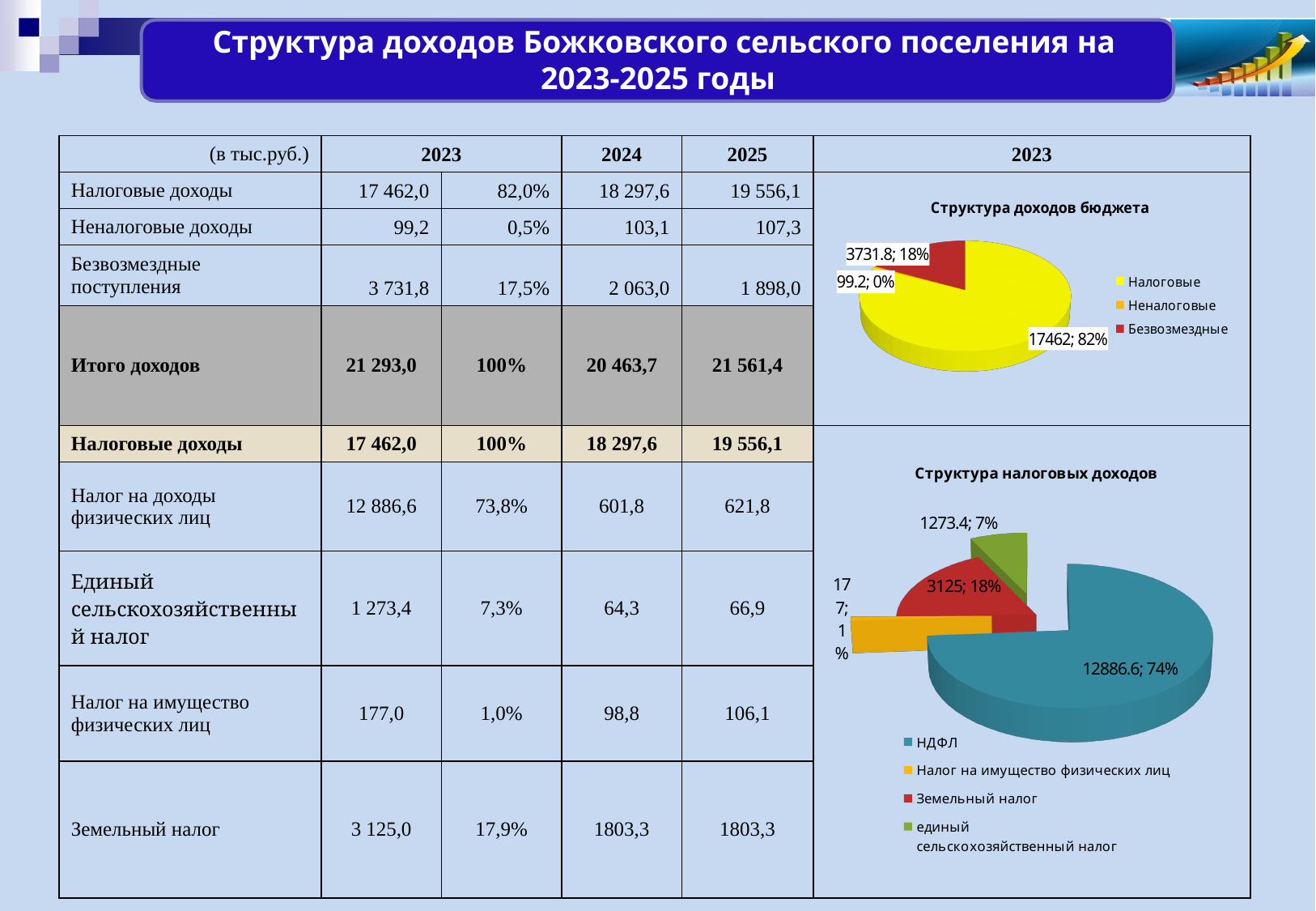
In the chart titled "Структура налоговых доходов", what is the difference between the НДФЛ value and the Земельный налог value? 9761.6 In the chart titled "Структура доходов бюджета", what share of the pie does the Безвозмездные slice have? 18% In the chart titled "Структура налоговых доходов", how many slices does the pie have? 4 In the chart titled "Структура доходов бюджета", what colour is the Безвозмездные slice? Red In the chart titled "Структура доходов бюджета", what value is shown for the Налоговые slice? 17462; 82% In the chart titled "Структура налоговых доходов", which category has the largest slice? НДФЛ In the chart titled "Структура налоговых доходов", which is larger: Земельный налог or единый сельскохозяйственный налог? Земельный налог In the chart titled "Структура доходов бюджета", how many entries does the legend list? 3 In the chart titled "Структура налоговых доходов", what share of the pie does НДФЛ have? 74% What type of chart is the chart titled "Структура налоговых доходов"? Pie chart In the chart titled "Структура налоговых доходов", what value is shown for the Земельный налог slice? 3125; 18% In the chart titled "Структура доходов бюджета", which category has the smallest slice? Неналоговые